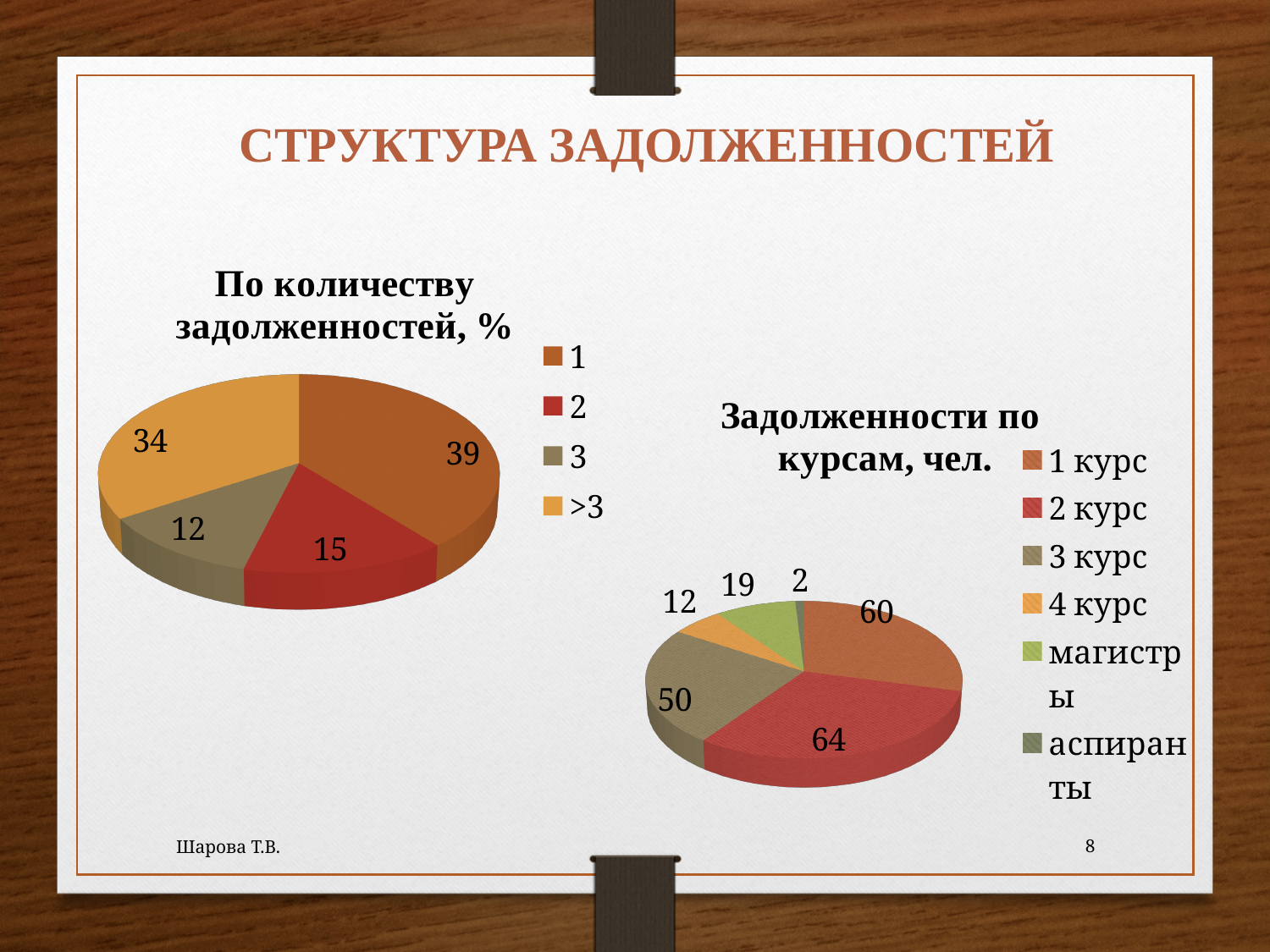
In the chart 'По количеству задолженностей, %', what is the difference between the values for '1' and '2'? 24 How many categories does the legend of the chart 'По количеству задолженностей, %' list? 4 In the chart 'По количеству задолженностей, %', what is the value for the category '>3'? 34 In the chart 'Задолженности по курсам, чел.', what is the value for 'магистры'? 19 In the chart 'Задолженности по курсам, чел.', what is the value for '2 курс'? 64 How many categories does the legend of the chart 'Задолженности по курсам, чел.' list? 6 In the chart 'Задолженности по курсам, чел.', which is larger: the value for '3 курс' or for '4 курс'? 3 курс In the chart 'По количеству задолженностей, %', what is the value for the category '1'? 39 In the chart 'Задолженности по курсам, чел.', which category has the largest value? 2 курс In the chart 'По количеству задолженностей, %', which category has the smallest slice? 3 What type of chart is 'Задолженности по курсам, чел.'? Pie chart In the chart 'Задолженности по курсам, чел.', which category has the smallest value? аспиранты